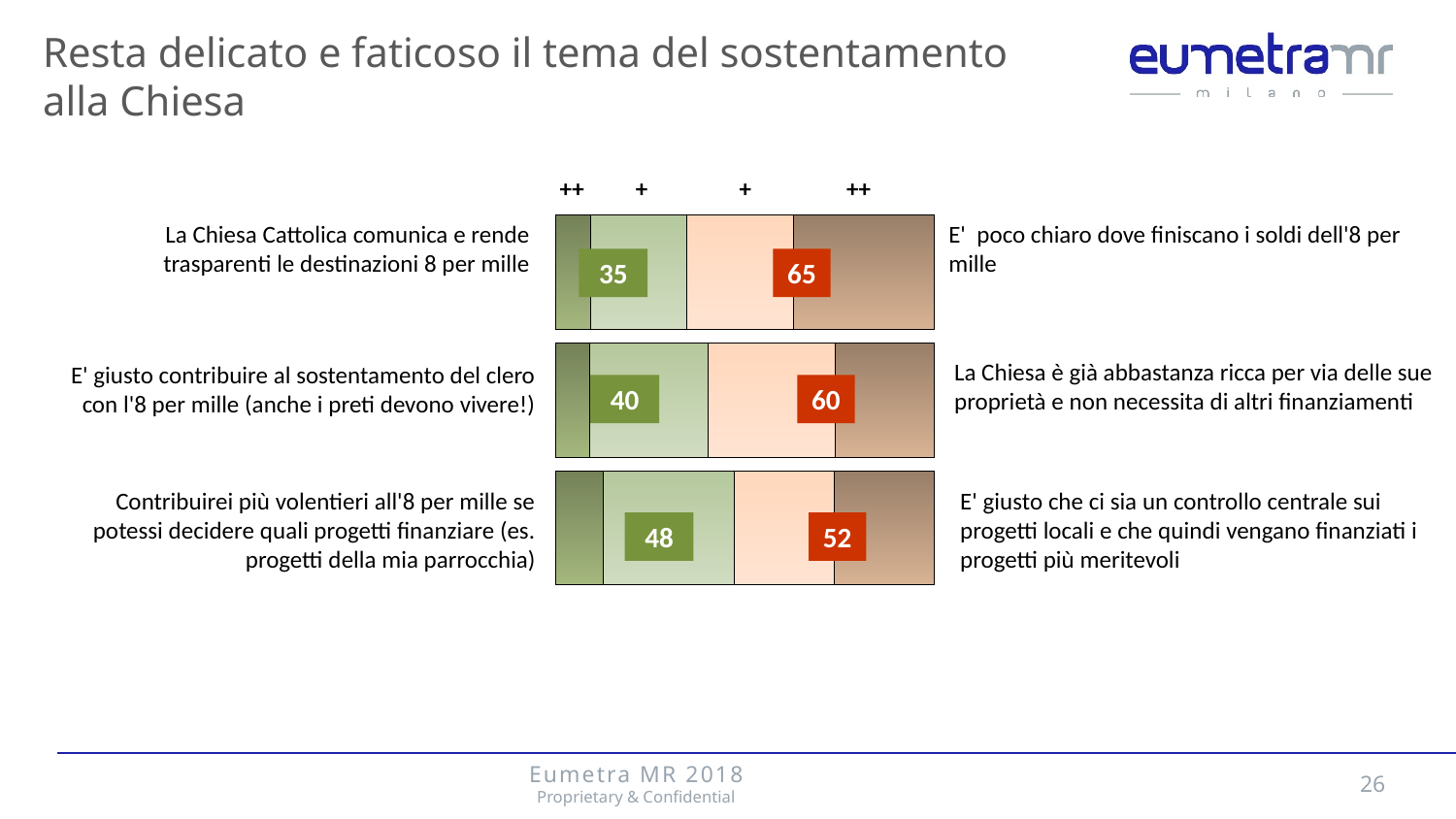
How many stacked bars are shown on the slide? 3 What value is shown on the green side of the bar for "La Chiesa Cattolica comunica e rende trasparenti le destinazioni 8 per mille"? 35 What value is shown on the green side of the bar for "E' giusto contribuire al sostentamento del clero con l'8 per mille"? 40 In the bottom bar, which is larger: the green value or the orange value? The orange value (52) What value is shown on the green side of the bar for "Contribuirei più volentieri all'8 per mille se potessi decidere quali progetti finanziare"? 48 What value is shown on the orange side of the top bar, next to "E' poco chiaro dove finiscano i soldi dell'8 per mille"? 65 What kind of chart is shown on the slide? Stacked horizontal bar chart In the top bar, what is the difference between the orange value (65) and the green value (35)? 30 Which left-hand statement has the lowest green value? La Chiesa Cattolica comunica e rende trasparenti le destinazioni 8 per mille What value is shown on the orange side of the bottom bar, next to "E' giusto che ci sia un controllo centrale sui progetti locali"? 52 What value is shown on the orange side of the middle bar, next to "La Chiesa è già abbastanza ricca per via delle sue proprietà"? 60 Which left-hand statement has the highest green value? Contribuirei più volentieri all'8 per mille se potessi decidere quali progetti finanziare